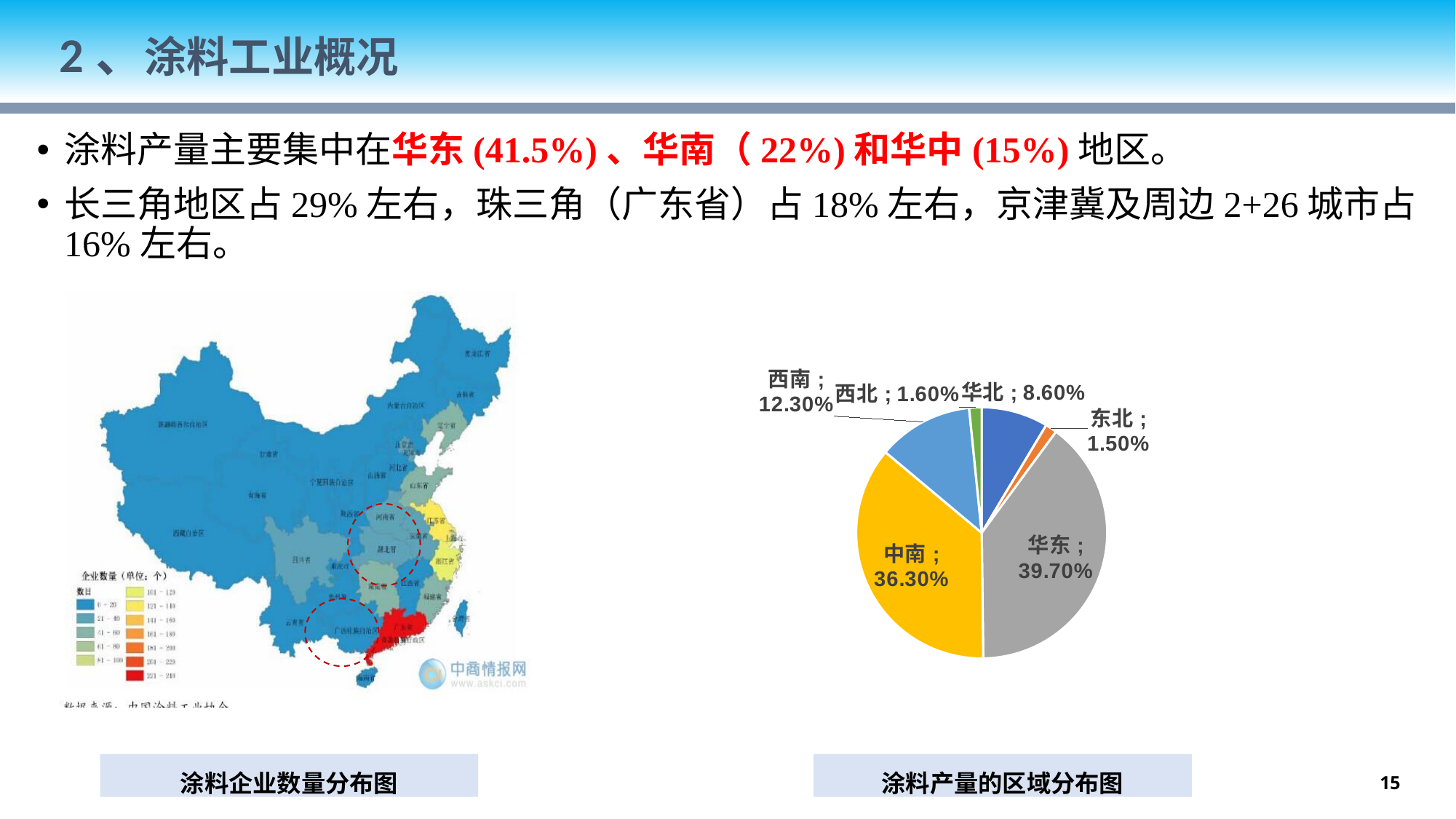
In the pie chart titled 涂料产量的区域分布图, what is the difference between the shares of 华东 and 中南? 3.40% In the pie chart titled 涂料产量的区域分布图, what is the share for 东北? 1.50% In the pie chart titled 涂料产量的区域分布图, which region has the smallest share? 东北 In the pie chart titled 涂料产量的区域分布图, what is the combined share of 华东 and 中南? 76.00% In the pie chart titled 涂料产量的区域分布图, what is the share for 中南? 36.30% What kind of chart is the chart titled 涂料产量的区域分布图? Pie chart In the pie chart titled 涂料产量的区域分布图, what is the share for 华北? 8.60% In the pie chart titled 涂料产量的区域分布图, which has a larger share, 西南 or 华北? 西南 In the pie chart titled 涂料产量的区域分布图, which region has the largest share? 华东 In the pie chart titled 涂料产量的区域分布图, what is the share for 华东? 39.70% In the pie chart titled 涂料产量的区域分布图, what is the share for 西南? 12.30% How many slices does the pie chart titled 涂料产量的区域分布图 have? 6